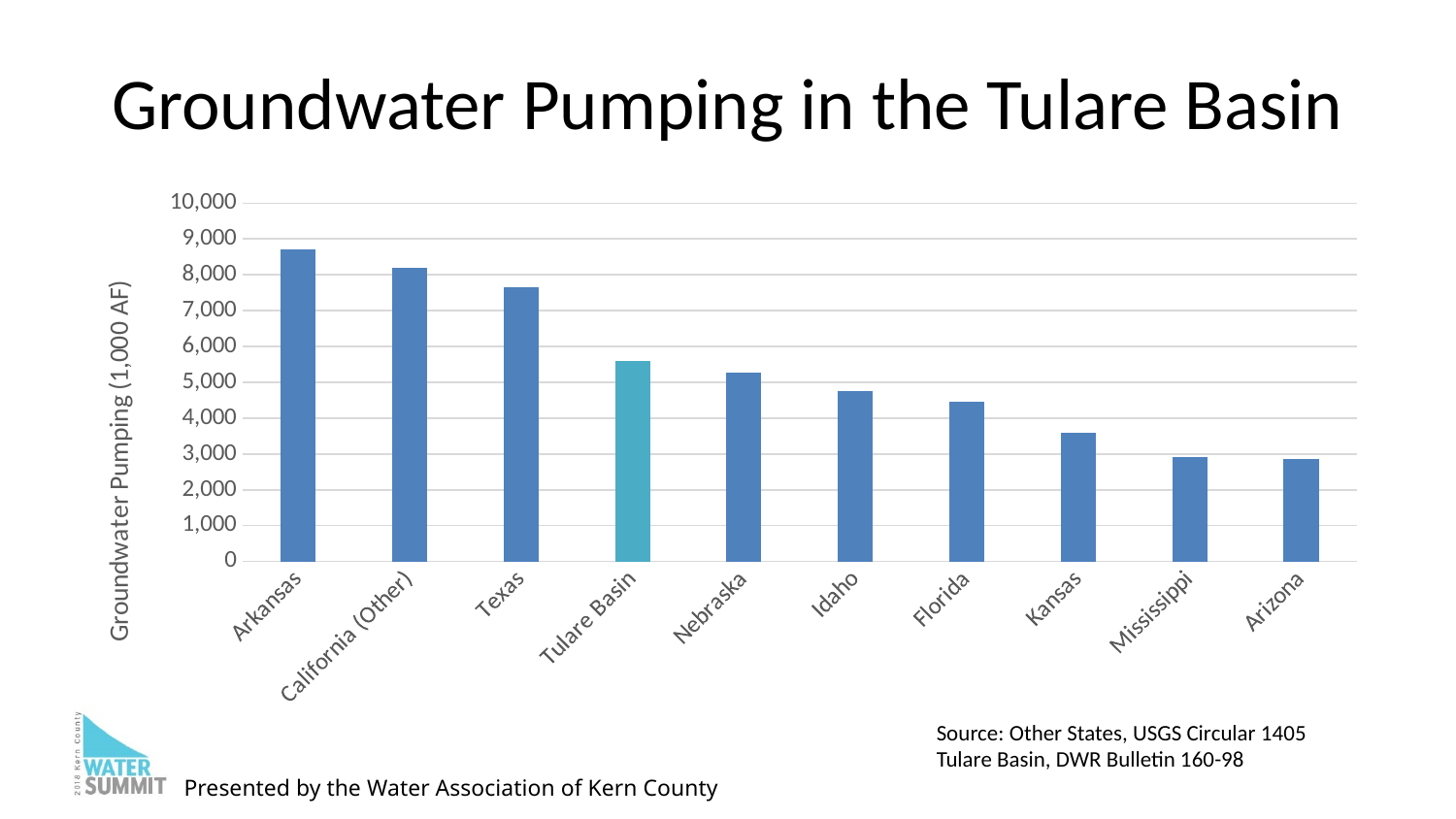
Is the value for Idaho greater or less than 5,000? less Which is larger, the value for Tulare Basin or the value for Florida? Tulare Basin Is the value for Texas greater or less than 8,000? less Which category has the highest groundwater pumping value? Arkansas Is the value for Tulare Basin greater or less than 5,000? greater Which category's bar is shown in a different colour from the others? Tulare Basin What is the label on the vertical axis of the chart? Groundwater Pumping (1,000 AF) What kind of chart is shown on the slide? Bar chart How many categories are plotted on the chart? 10 Do the values rise or fall moving from left to right along the x axis? Fall